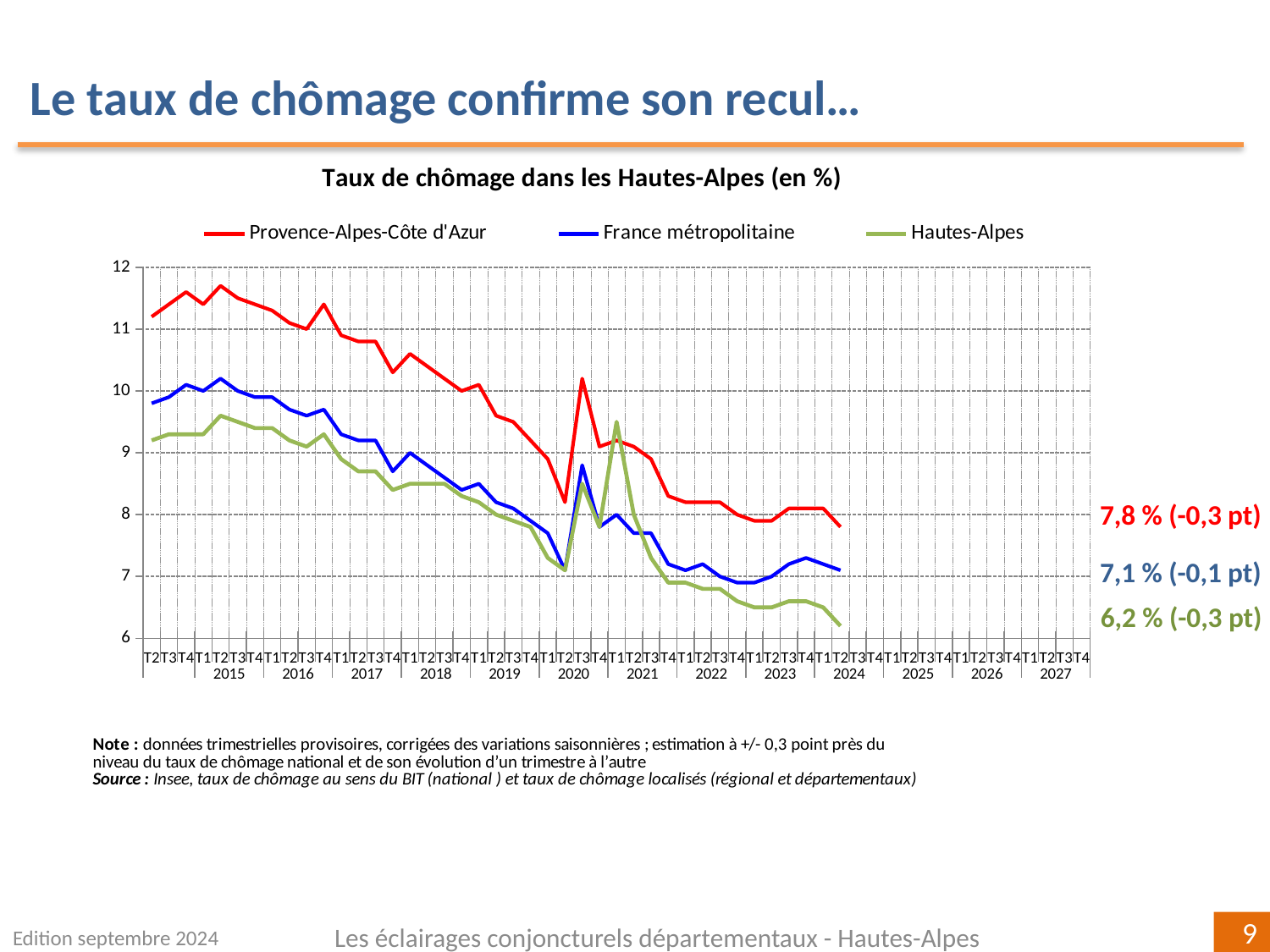
What is the latest unemployment rate shown for Hautes-Alpes? 6,2 % Which series has the lowest value at the end of the period? Hautes-Alpes Which series is drawn in green? Hautes-Alpes What is the latest unemployment rate shown for Provence-Alpes-Côte d'Azur? 7,8 % At the latest point, which is higher: the rate for France métropolitaine or for Hautes-Alpes? France métropolitaine Overall, do the unemployment rates rise or fall from 2014 to 2024? fall How many series does the legend list? 3 What is the difference between the latest rates for Provence-Alpes-Côte d'Azur and Hautes-Alpes? 1,6 points What kind of chart is shown on the slide? line chart By how much did the Hautes-Alpes rate change over the last quarter, according to the annotation? -0,3 pt Is the value for Provence-Alpes-Côte d'Azur at the start of the series (T2 2014) greater or less than 11? greater What is the latest unemployment rate shown for France métropolitaine? 7,1 %